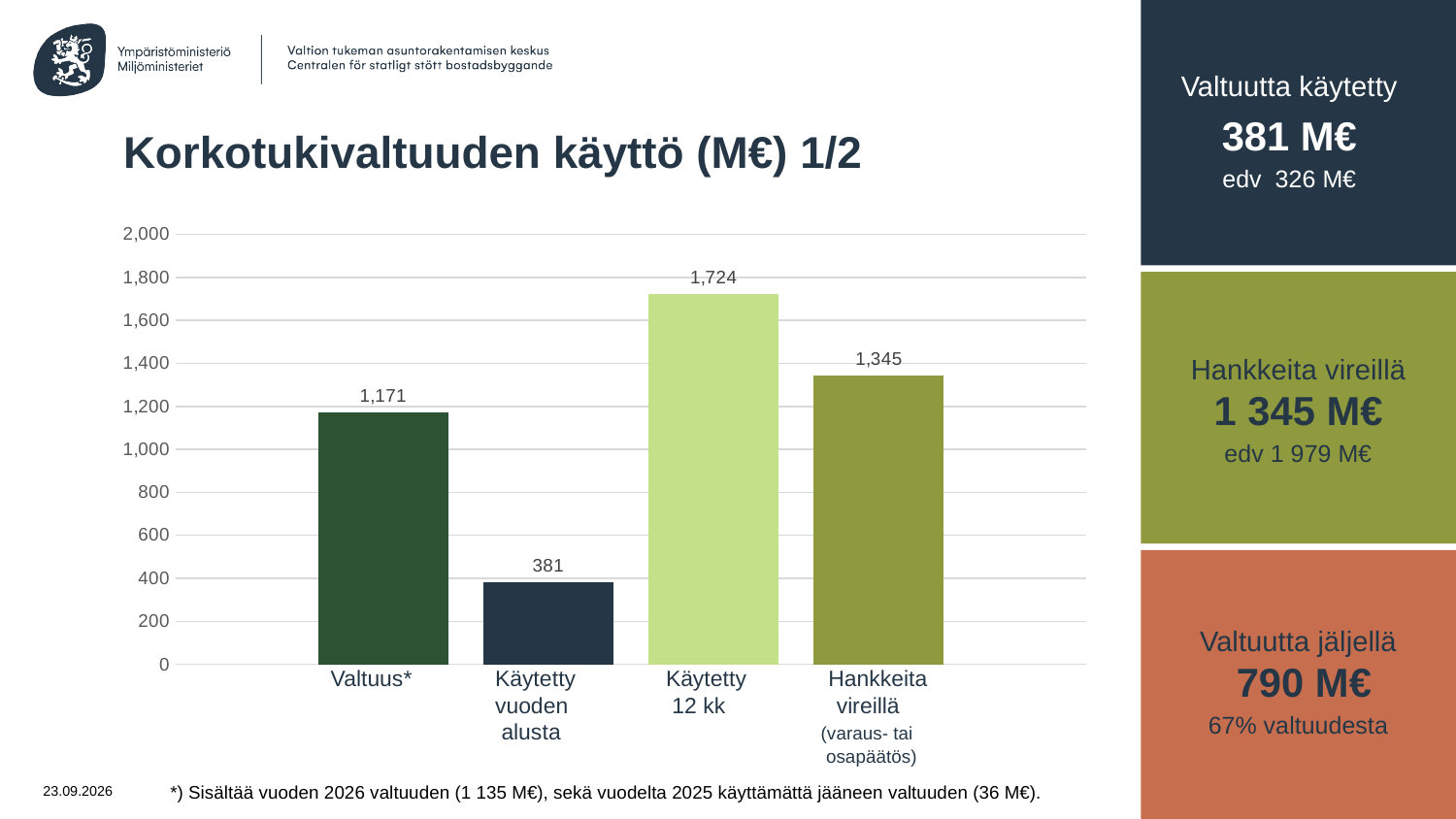
Which category has the highest value in the chart? Käytetty 12 kk What is the difference between the Valtuus* value and the Käytetty vuoden alusta value? 790 What is the value of the Hankkeita vireillä bar? 1,345 What is the value of the Käytetty vuoden alusta bar? 381 What is the value of the Valtuus* bar? 1,171 What type of chart is shown on the slide? Bar chart How many bars are shown in the chart? 4 Which is larger, the Valtuus* value or the Hankkeita vireillä value? Hankkeita vireillä What is the difference between the Käytetty 12 kk value and the Hankkeita vireillä value? 379 Which category has the lowest value in the chart? Käytetty vuoden alusta Is the value for Käytetty vuoden alusta greater or less than 400? less What is the value of the Käytetty 12 kk bar? 1,724